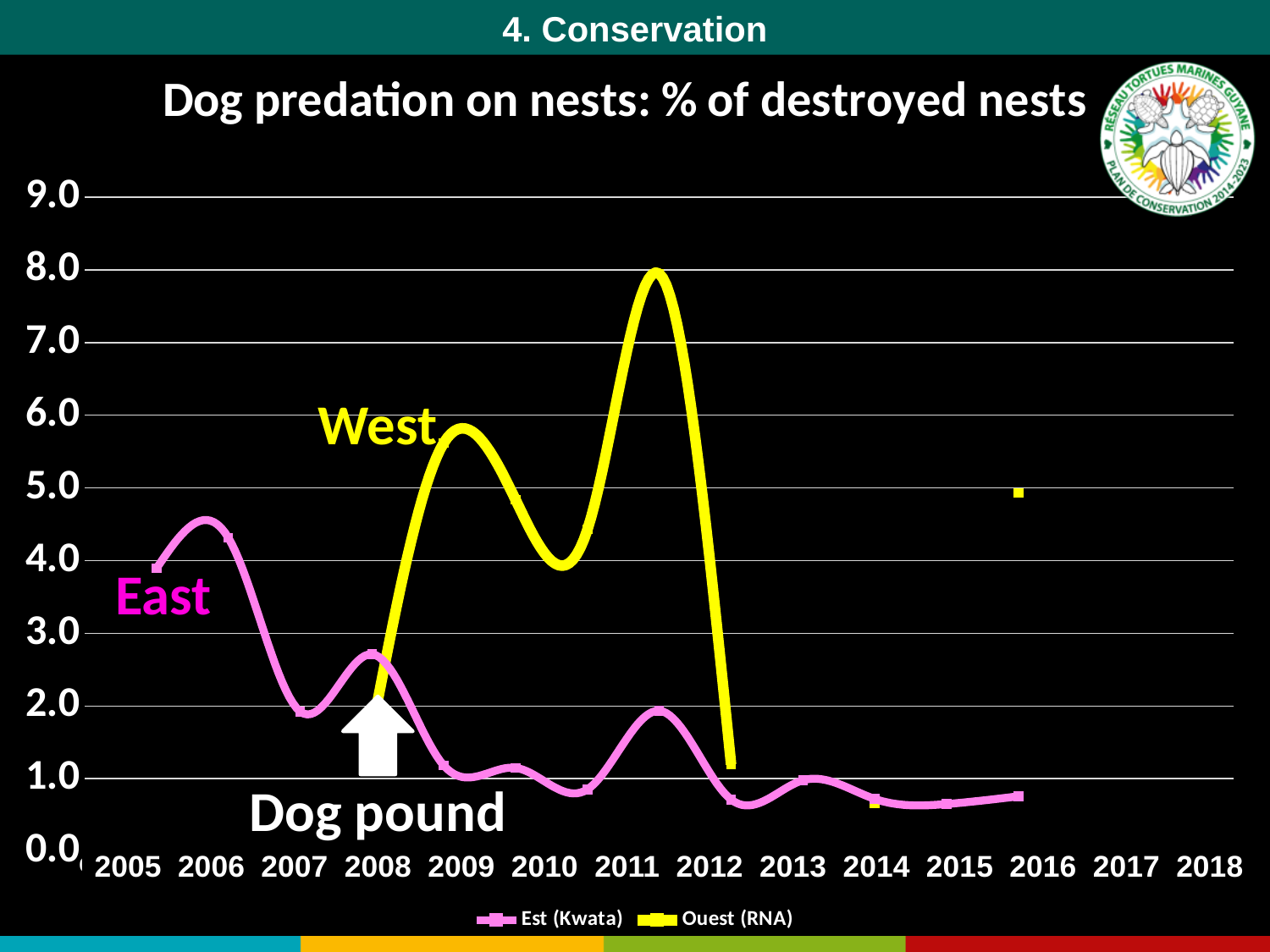
Is the value for Ouest (RNA) in 2009 greater or less than 5.0? greater How many years are labelled on the x axis? 14 Is the value for Est (Kwata) in 2005 greater or less than 3.0? greater Does the Est (Kwata) series rise or fall between 2006 and 2010? fall How many series does the legend list? 2 In which year does the Est (Kwata) series reach its highest value? 2006 In 2011, which series has the larger value, Est (Kwata) or Ouest (RNA)? Ouest (RNA) What kind of chart is shown on the slide? line chart What is the title of the chart? Dog predation on nests: % of destroyed nests